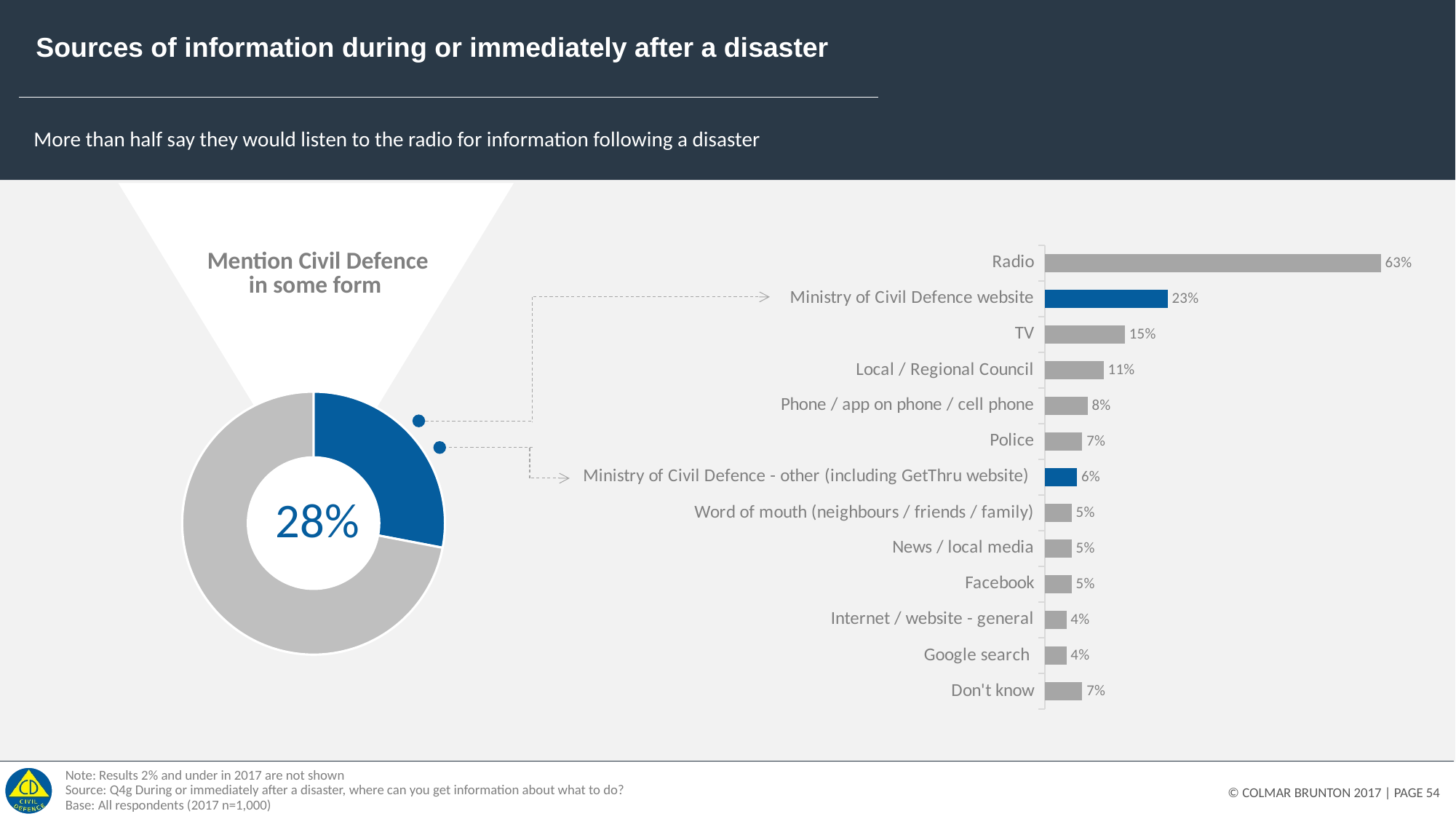
How many sources are listed in the bar chart? 13 In the bar chart, which is larger: the value for Phone / app on phone / cell phone or the value for Police? Phone / app on phone / cell phone In the bar chart, which source has the highest value? Radio What type of chart is used on the right side of the slide to show the sources of information? Bar chart What percentage is shown in the centre of the donut chart for those who mention Civil Defence in some form? 28% In the bar chart, what is the value for Ministry of Civil Defence website? 23% In the bar chart, what is the difference between Ministry of Civil Defence website and Ministry of Civil Defence - other (including GetThru website)? 17 percentage points In the bar chart, what is the difference between the values for Radio and TV? 48 percentage points In the bar chart, what is the value for Local / Regional Council? 11% In the bar chart, what percentage of respondents say they would use the radio for information? 63% In the bar chart, what is the value for Don't know? 7% In the bar chart, which two bars are highlighted in blue? Ministry of Civil Defence website and Ministry of Civil Defence - other (including GetThru website)